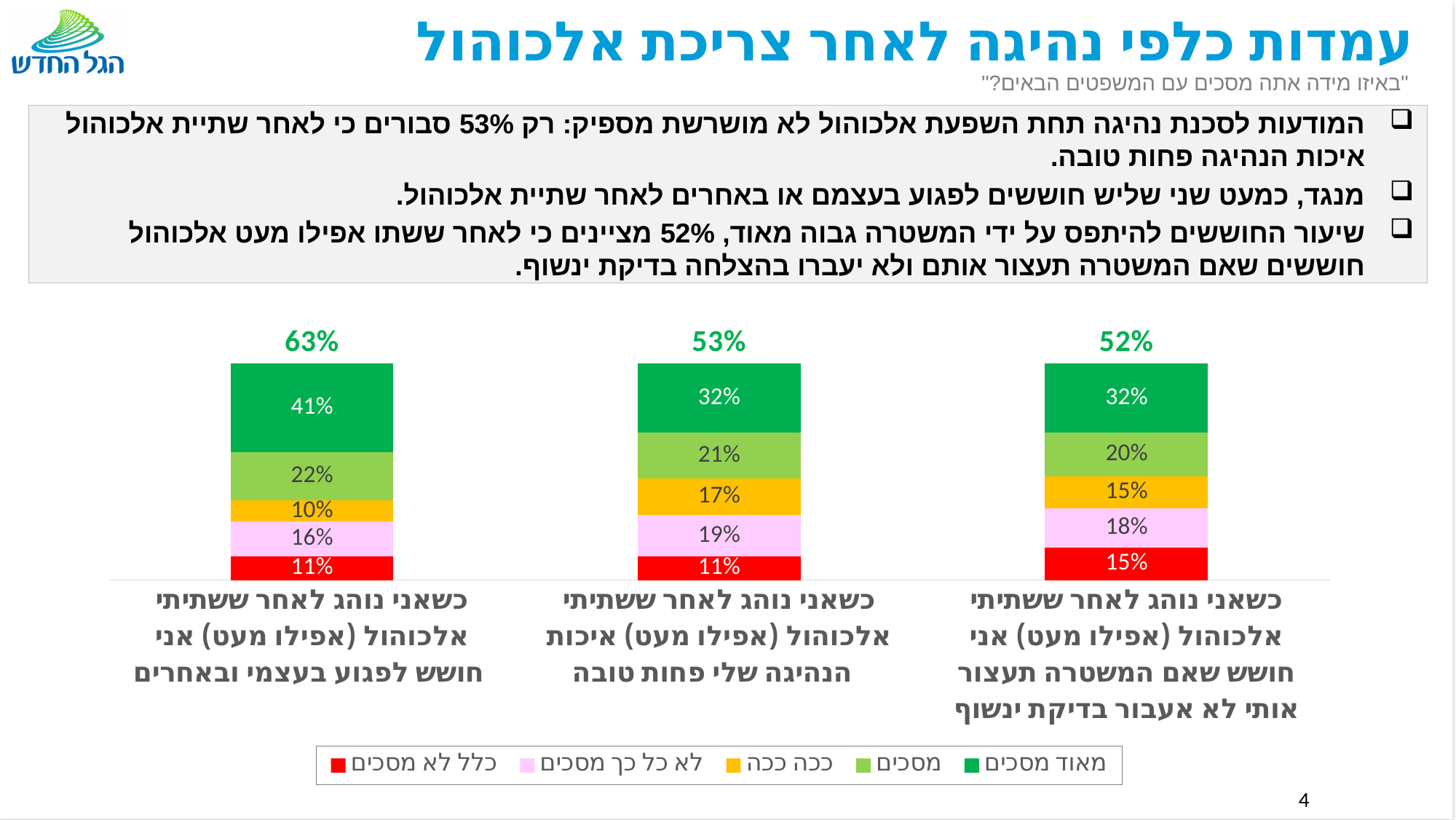
Which legend entry is shown in red? כלל לא מסכים What is the 'כלל לא מסכים' value for the statement 'אני חושש שאם המשטרה תעצור אותי לא אעבור בדיקת ינשוף'? 15% Which statement has the highest 'מאוד מסכים' share? כשאני נוהג לאחר ששתיתי אלכוהול (אפילו מעט) אני חושש לפגוע בעצמי ובאחרים What is the difference between the 'מאוד מסכים' value for 'אני חושש לפגוע בעצמי ובאחרים' (41%) and for 'איכות הנהיגה שלי פחות טובה' (32%)? 9% How many bars (statements) are shown in the chart? 3 What is the 'ככה ככה' value for the statement 'איכות הנהיגה שלי פחות טובה'? 17% Which is larger: the 'לא כל כך מסכים' value for 'איכות הנהיגה שלי פחות טובה' or for 'אני חושש לפגוע בעצמי ובאחרים'? איכות הנהיגה שלי פחות טובה (19%) What is the green total shown above the bar for 'איכות הנהיגה שלי פחות טובה'? 53% How many series does the legend list? 5 What is the 'מאוד מסכים' value for the statement 'אני חושש לפגוע בעצמי ובאחרים'? 41% What kind of chart is shown on the slide? Stacked bar chart Which statement has the lowest 'ככה ככה' share? כשאני נוהג לאחר ששתיתי אלכוהול (אפילו מעט) אני חושש לפגוע בעצמי ובאחרים